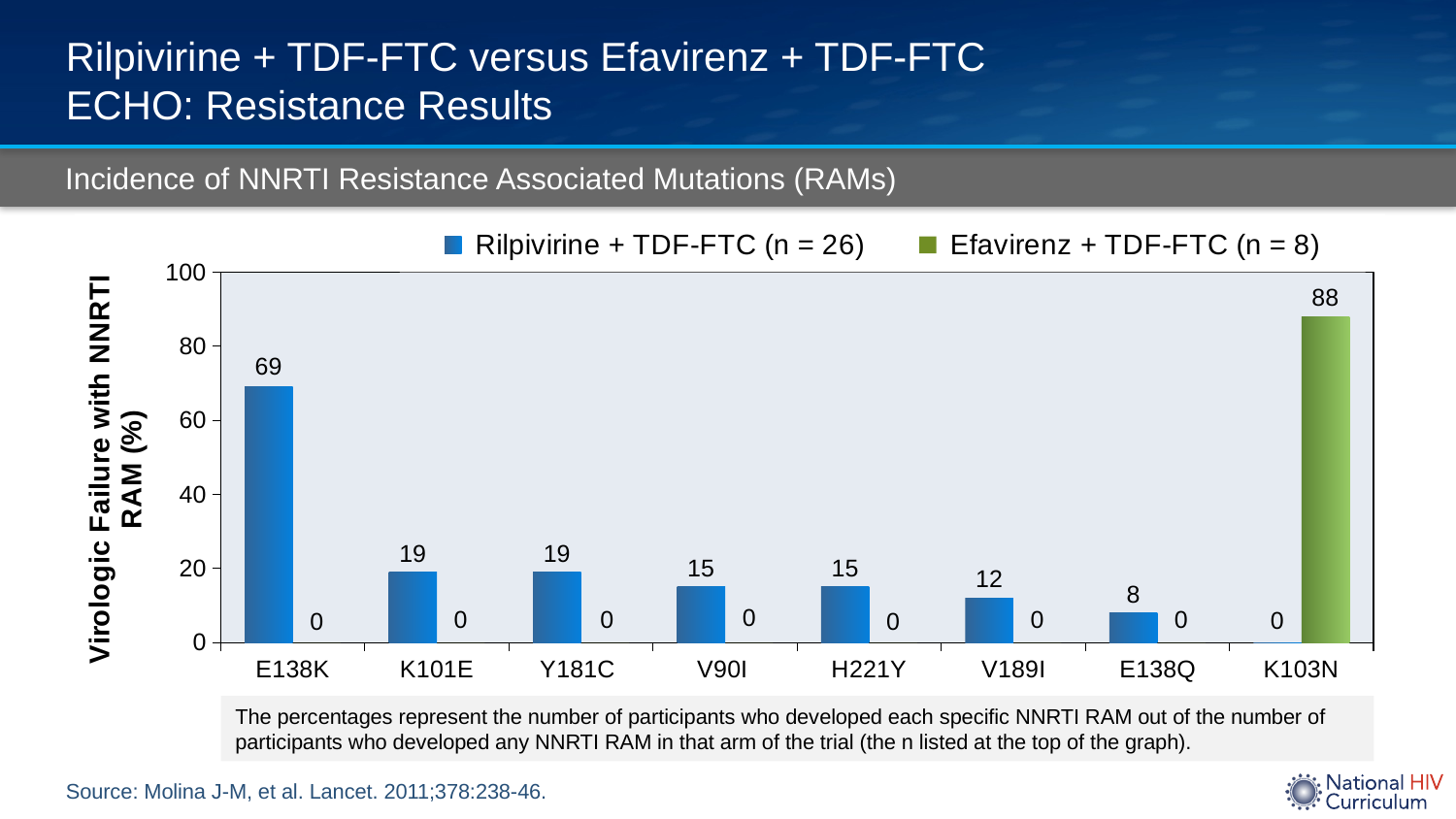
What is the value for E138Q in the Efavirenz + TDF-FTC series? 0 Which is larger: the Rilpivirine + TDF-FTC value for V90I or for E138Q? V90I What kind of chart is shown on the slide? Bar chart Which mutation has the highest value in the Rilpivirine + TDF-FTC series? E138K What is the value for V189I in the Rilpivirine + TDF-FTC series? 12 Which mutation has the lowest value in the Rilpivirine + TDF-FTC series? K103N How many mutation categories are shown on the x axis? 8 What is the value for E138K in the Rilpivirine + TDF-FTC series? 69 How many series does the legend list? 2 What is the label of the y axis? Virologic Failure with NNRTI RAM (%) What is the value for K103N in the Efavirenz + TDF-FTC series? 88 What is the difference between the Rilpivirine + TDF-FTC value for E138K and the Efavirenz + TDF-FTC value for K103N? 19